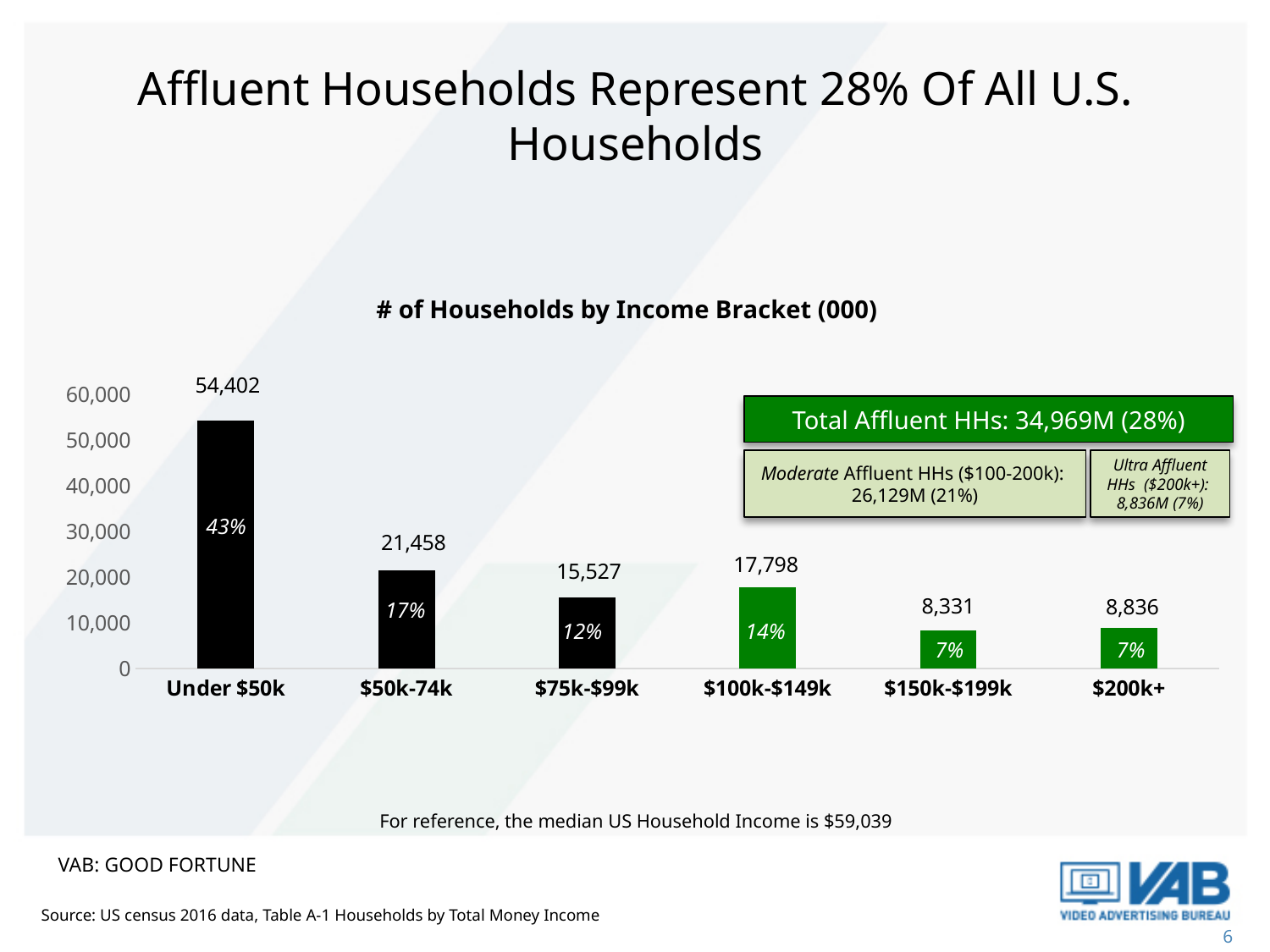
What is the difference in households (000) between the $100k-$149k and $75k-$99k brackets? 2,271 What is the difference in households (000) between the Under $50k and $50k-74k brackets? 32,944 What is the title of the chart? # of Households by Income Bracket (000) What is the number of households (000) in the $100k-$149k bracket? 17,798 Which income bracket has the lowest number of households? $150k-$199k What type of chart is used to show households by income bracket? bar chart What percentage label is shown inside the $50k-74k bar? 17% Which bracket has more households, $100k-$149k or $75k-$99k? $100k-$149k What is the number of households (000) in the Under $50k income bracket? 54,402 How many income brackets are shown on the x axis? 6 Is the value for the $50k-74k bracket greater or less than 20,000? greater Which income bracket has the highest number of households? Under $50k